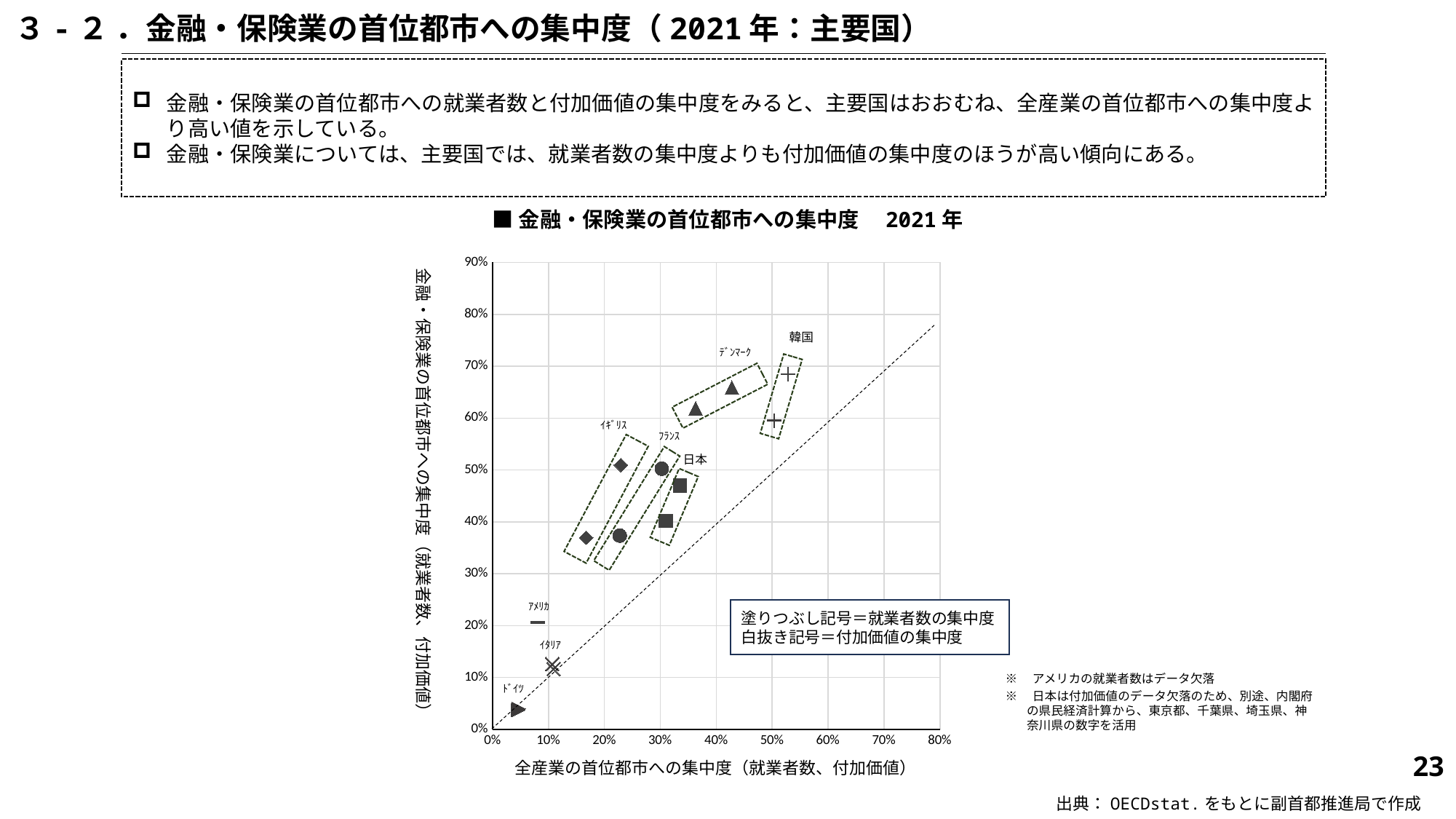
Are the vertical-axis values for 韓国 greater or less than 50%? greater What is the title of the chart? 金融・保険業の首位都市への集中度 2021年 Is the vertical-axis value for ドイツ greater or less than 10%? less Which country has higher vertical-axis values, 韓国 or ドイツ? 韓国 Is the vertical-axis value for イタリア greater or less than 20%? less According to the legend box, what do the filled symbols represent? 就業者数の集中度 How many countries are labelled on the chart? 8 Which country has higher vertical-axis values, デンマーク or イタリア? デンマーク Do the plotted points generally rise or fall as the horizontal-axis value increases? rise Which country's points are lowest on the vertical axis? ドイツ What kind of chart is shown on the slide? Scatter chart